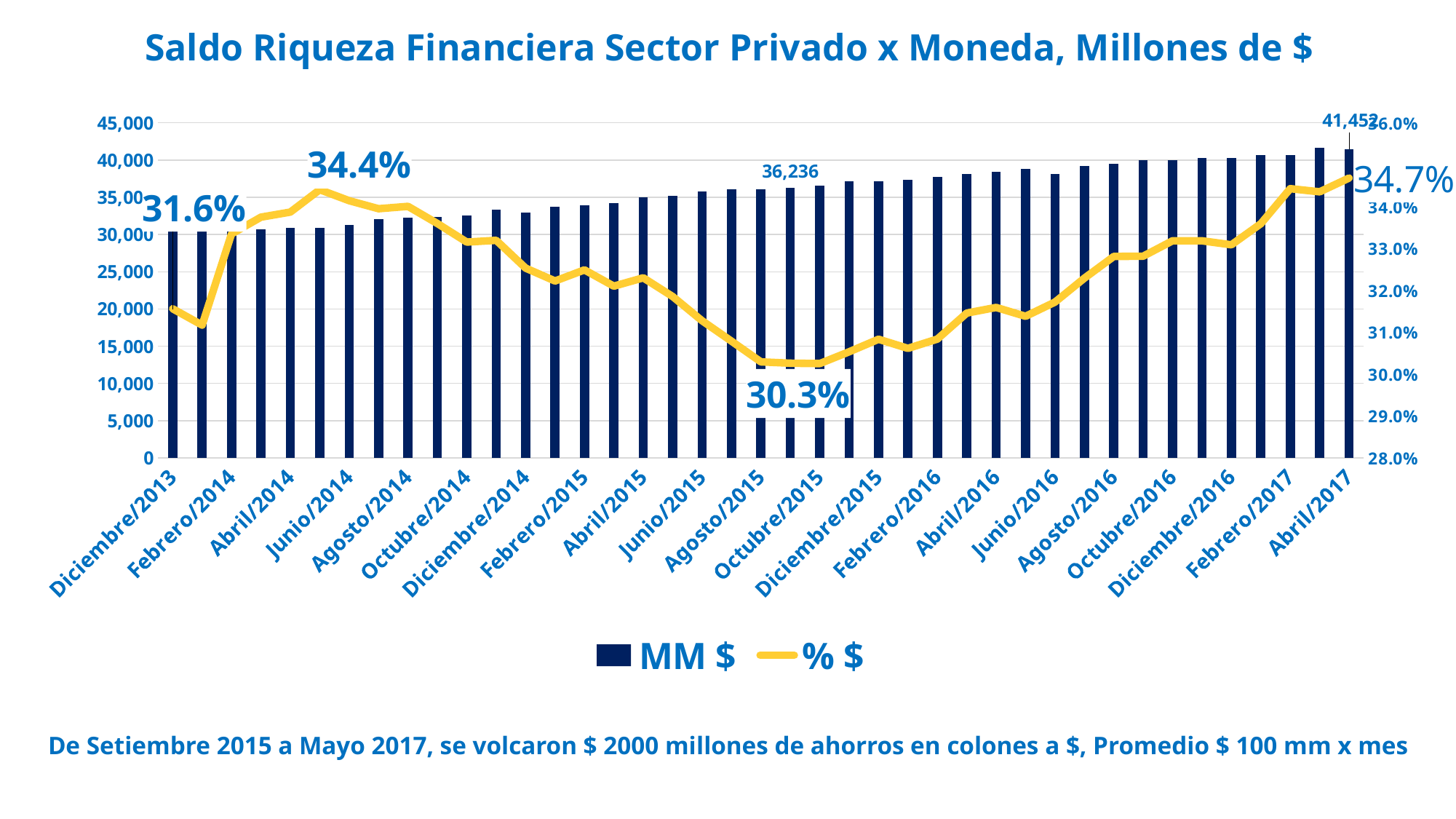
What is the % $ value labeled at the start of the line, at Diciembre/2013? 31.6% Which is larger, the % $ value at Junio/2014 or at Octubre/2015? Junio/2014 What are the two legend entries of the chart? MM $ and % $ Is the MM $ bar for Diciembre/2013 greater or less than 25,000? greater What is the % $ value labeled at the peak of the line in mid-2014? 34.4% What is the difference between the final labeled % $ value (34.7%) and the lowest labeled value (30.3%)? 4.4 percentage points What is the % $ value labeled at the end of the line (Abril/2017 area)? 34.7% What kind of chart is shown on the slide? A combined bar and line chart How many series does the legend list? 2 Do the MM $ bars generally rise or fall from Diciembre/2013 to Abril/2017? rise What is the value printed on the last (rightmost) bar of the chart? 41,452 What is the lowest % $ value labeled on the line, reached in late 2015? 30.3%